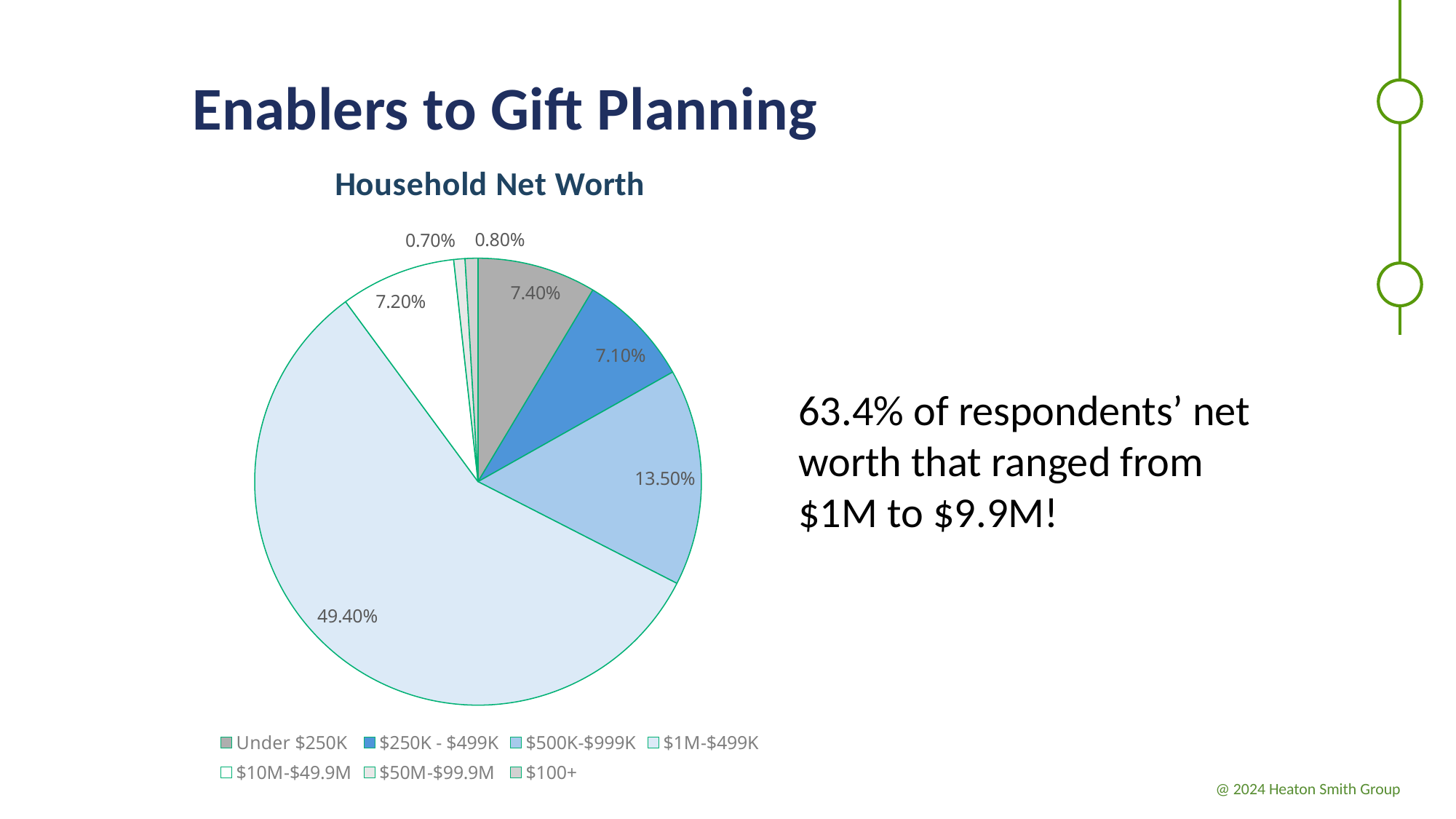
How many slices does the pie chart have? 7 What percentage is shown for the $10M-$49.9M slice? 7.20% Which category has the smallest share of the pie? $50M-$99.9M What is the combined percentage of the $50M-$99.9M and $100+ slices? 1.50% What percentage is shown for the $500K-$999K slice? 13.50% Which category has the largest share of the pie? $1M-$499K What is the title of the chart? Household Net Worth What percentage of the pie is the $1M-$499K slice? 49.40% What percentage is shown for the Under $250K slice? 7.40% What kind of chart is shown on the slide? Pie chart What is the difference in percentage points between the $500K-$999K slice and the $250K - $499K slice? 6.40% Which slice is larger, Under $250K or $250K - $499K? Under $250K